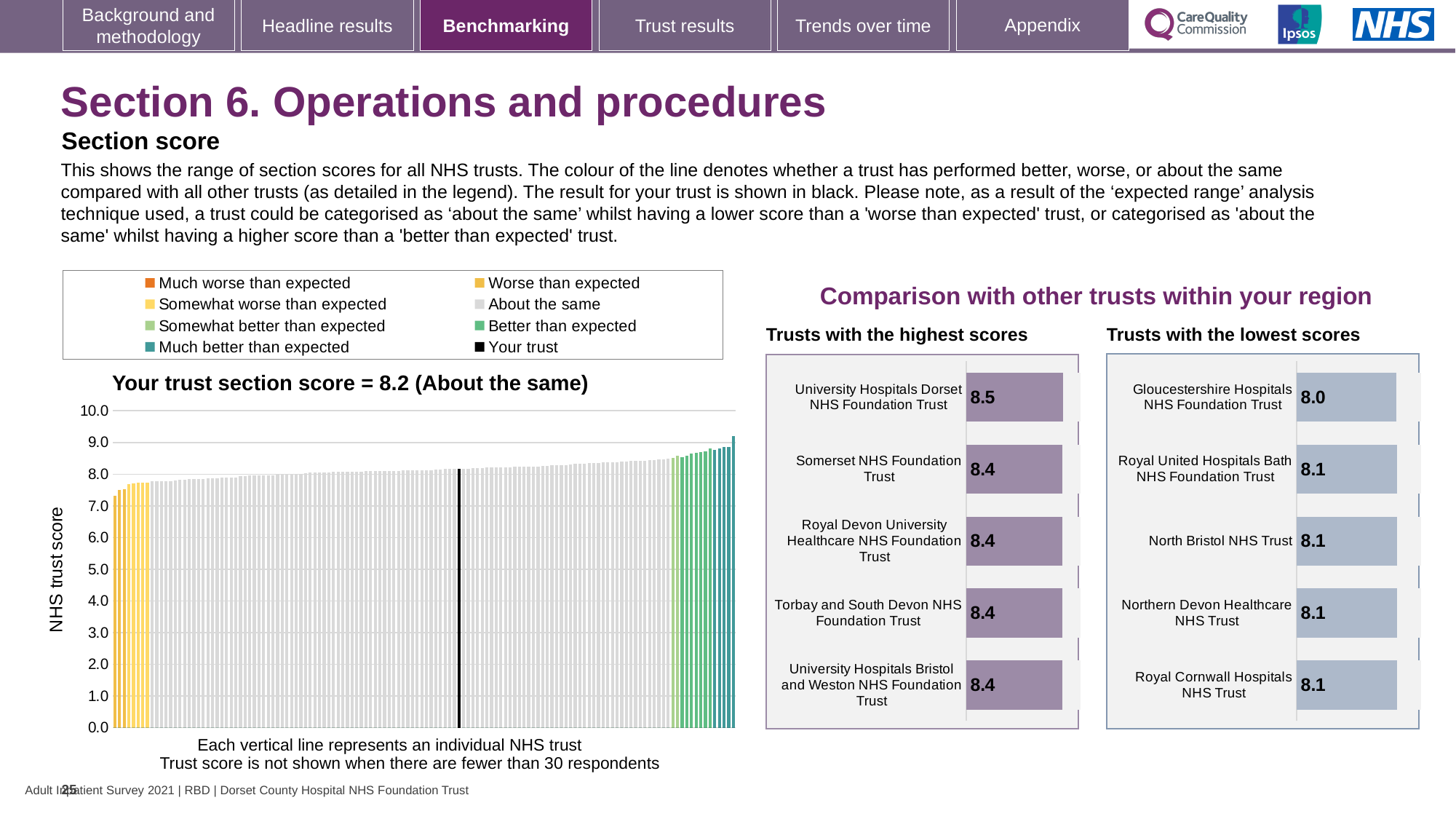
On the 'Your trust section score' chart, what is the section score for your trust? 8.2 What is the label on the vertical axis of the 'Your trust section score' chart? NHS trust score On the 'Trusts with the lowest scores' chart, what is the score for Gloucestershire Hospitals NHS Foundation Trust? 8.0 How many entries does the legend above the 'Your trust section score' chart list? 8 On the 'Trusts with the lowest scores' chart, which has the larger score: Gloucestershire Hospitals NHS Foundation Trust or North Bristol NHS Trust? North Bristol NHS Trust On the 'Trusts with the lowest scores' chart, which trust has the lowest score? Gloucestershire Hospitals NHS Foundation Trust On the 'Trusts with the highest scores' chart, which trust has the highest score? University Hospitals Dorset NHS Foundation Trust On the 'Trusts with the highest scores' chart, what is the difference between the scores of University Hospitals Dorset NHS Foundation Trust and Somerset NHS Foundation Trust? 0.1 What kind of chart is the 'Your trust section score' chart? bar chart On the 'Trusts with the highest scores' chart, how many trusts are shown? 5 On the 'Trusts with the highest scores' chart, what is the score for University Hospitals Dorset NHS Foundation Trust? 8.5 On the 'Your trust section score' chart, which category is your trust placed in? About the same